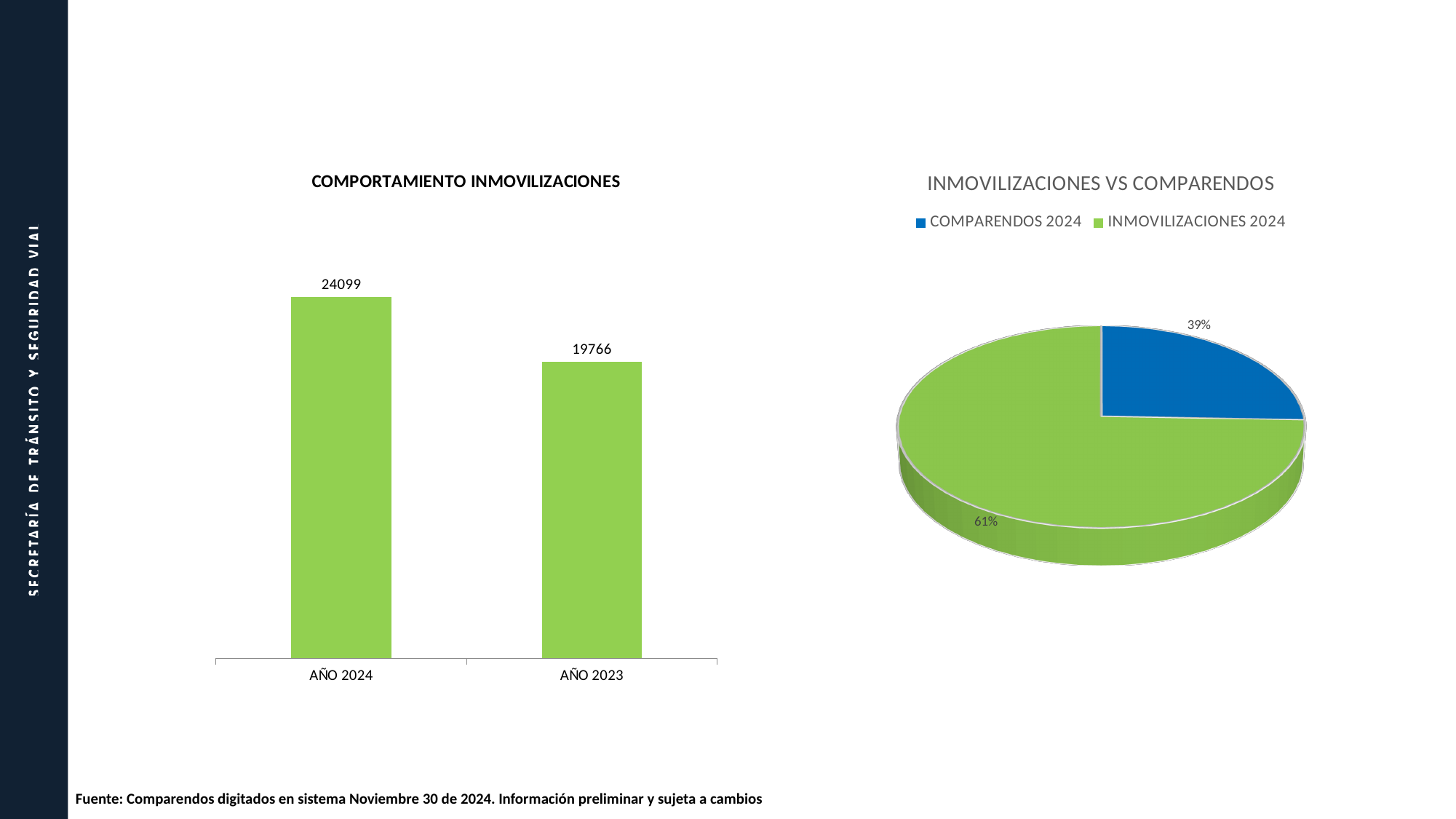
In the 'INMOVILIZACIONES VS COMPARENDOS' chart, what share does INMOVILIZACIONES 2024 have? 61% In the 'INMOVILIZACIONES VS COMPARENDOS' chart, which slice is larger, COMPARENDOS 2024 or INMOVILIZACIONES 2024? INMOVILIZACIONES 2024 In the 'COMPORTAMIENTO INMOVILIZACIONES' chart, how many categories are shown? 2 In the 'COMPORTAMIENTO INMOVILIZACIONES' chart, what is the value for AÑO 2023? 19766 In the 'COMPORTAMIENTO INMOVILIZACIONES' chart, what is the difference between the values for AÑO 2024 and AÑO 2023? 4333 In the 'INMOVILIZACIONES VS COMPARENDOS' chart, how many entries does the legend list? 2 In the 'COMPORTAMIENTO INMOVILIZACIONES' chart, what is the value for AÑO 2024? 24099 In the 'COMPORTAMIENTO INMOVILIZACIONES' chart, which category has the highest value? AÑO 2024 What kind of chart is 'COMPORTAMIENTO INMOVILIZACIONES'? Bar chart In the 'COMPORTAMIENTO INMOVILIZACIONES' chart, which category has the lowest value? AÑO 2023 In the 'INMOVILIZACIONES VS COMPARENDOS' chart, what share does COMPARENDOS 2024 have? 39% What kind of chart is 'INMOVILIZACIONES VS COMPARENDOS'? Pie chart